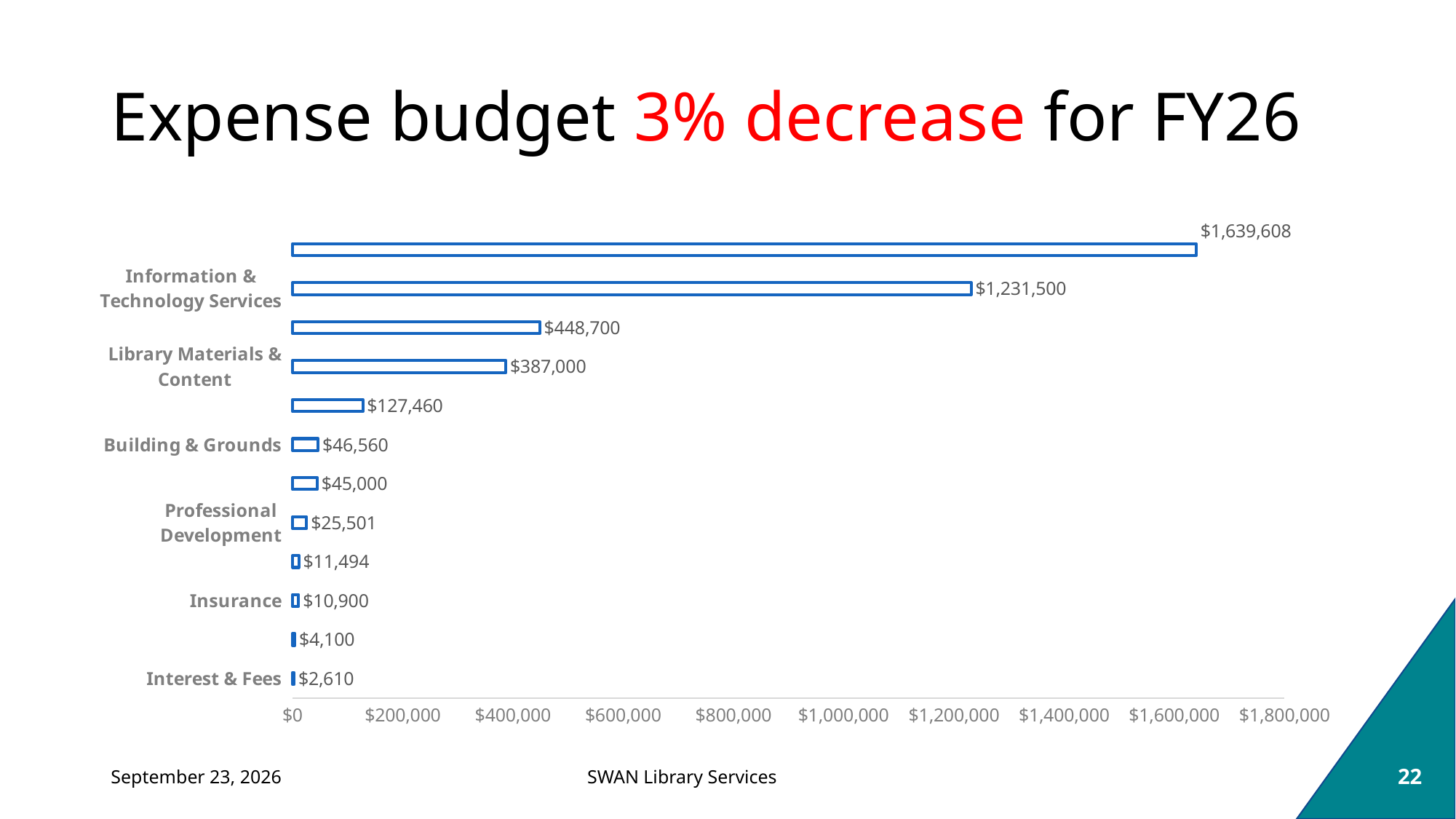
What is the value for Insurance? $10,900 Which is larger, Building & Grounds or Professional Development? Building & Grounds What is the value for Professional Development? $25,501 What is the value for Building & Grounds? $46,560 What is the difference between Library Materials & Content and Building & Grounds? $340,440 What type of chart is shown on the slide? Bar chart What is the value for Interest & Fees? $2,610 What is the value for Library Materials & Content? $387,000 What is the largest value shown on the chart? $1,639,608 What is the value for Information & Technology Services? $1,231,500 Which labeled category has the lowest value? Interest & Fees How many bars are plotted on the chart? 12